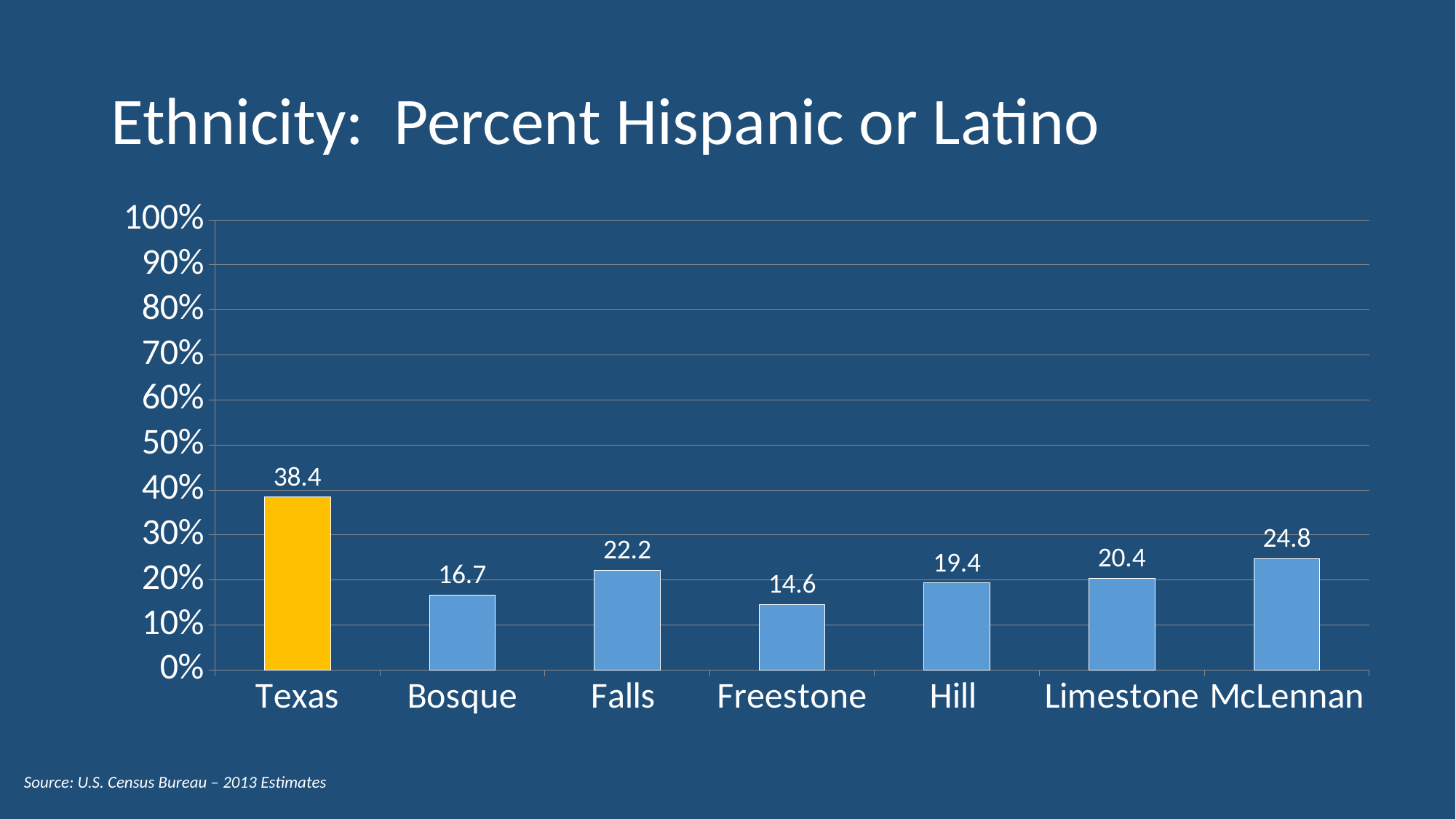
What is the difference between the values for McLennan and Hill? 5.4 What is the difference between the values for Texas and Bosque? 21.7 What is the value for McLennan? 24.8 Is the value for Texas greater or less than 30%? greater What is the title of the chart? Ethnicity: Percent Hispanic or Latino Which is larger, the value for Falls or the value for Limestone? Falls What kind of chart is shown on the slide? bar chart Which category has the lowest value? Freestone How many categories are shown on the x axis? 7 What is the value for Freestone? 14.6 What is the value for Texas? 38.4 Which category has the highest value? Texas